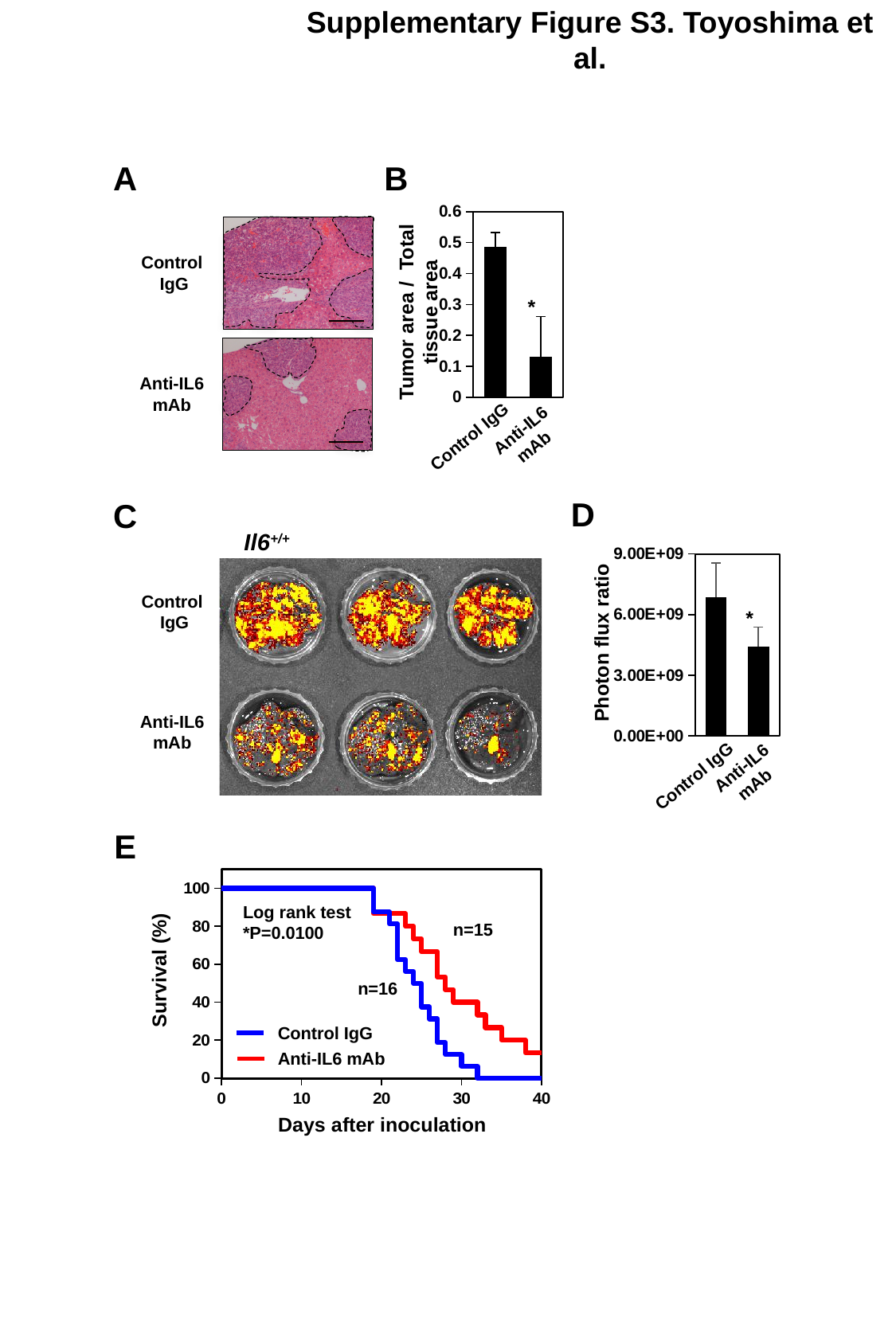
In chart E (Survival), how many series does the legend list? 2 In chart B (Tumor area / Total tissue area), is the value for Control IgG greater or less than 0.4? greater In chart D (Photon flux ratio), which category has the lower bar? Anti-IL6 mAb In chart E (Survival), does survival rise or fall as days after inoculation increase? fall In chart D, what is the label of the y axis? Photon flux ratio In chart D (Photon flux ratio), is the value for Control IgG greater or less than 6.00E+09? greater In chart B (Tumor area / Total tissue area), is the value for Anti-IL6 mAb greater or less than 0.2? less In chart B, how many categories are shown on the x axis? 2 In chart E (Survival), which group has the higher survival at day 30, Control IgG or Anti-IL6 mAb? Anti-IL6 mAb In chart B (Tumor area / Total tissue area), which category has the higher bar? Control IgG What kind of chart is chart B? bar chart